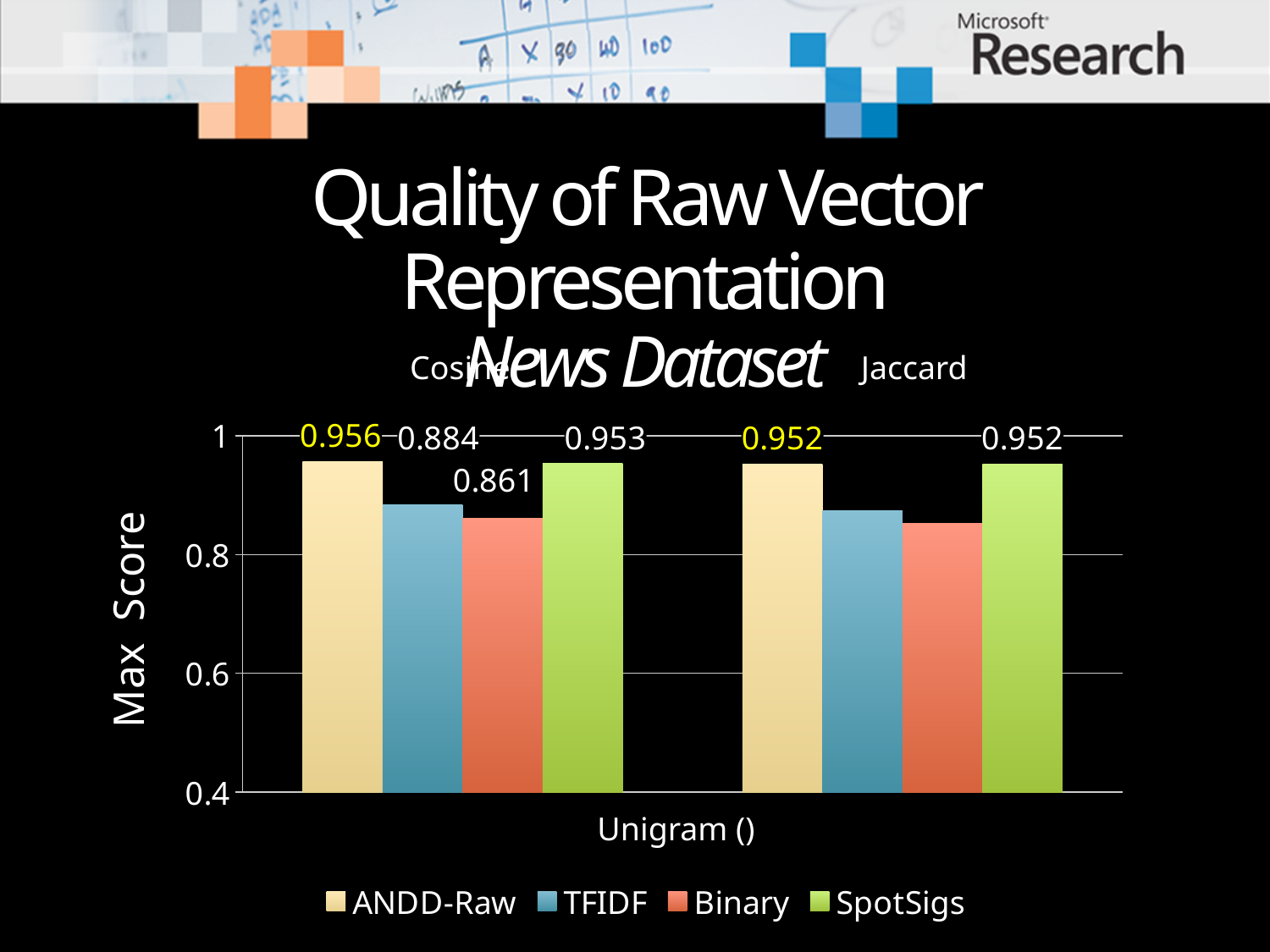
How many series does the legend list? 4 What is the Max Score for ANDD-Raw in the Jaccard group? 0.952 What is the Max Score for Binary in the Cosine group? 0.861 What is the title of the vertical axis? Max Score What is the Max Score for TFIDF in the Cosine group? 0.884 Is the Max Score for TFIDF in the Jaccard group greater or less than 0.8? greater What is the Max Score for ANDD-Raw in the Cosine group? 0.956 In the Cosine group, which is larger: the Max Score for TFIDF or for Binary? TFIDF What is the difference between the ANDD-Raw and Binary Max Scores in the Cosine group? 0.095 What is the Max Score for SpotSigs in the Cosine group? 0.953 Which series has the lowest Max Score in the Cosine group? Binary What kind of chart is shown on the slide? bar chart